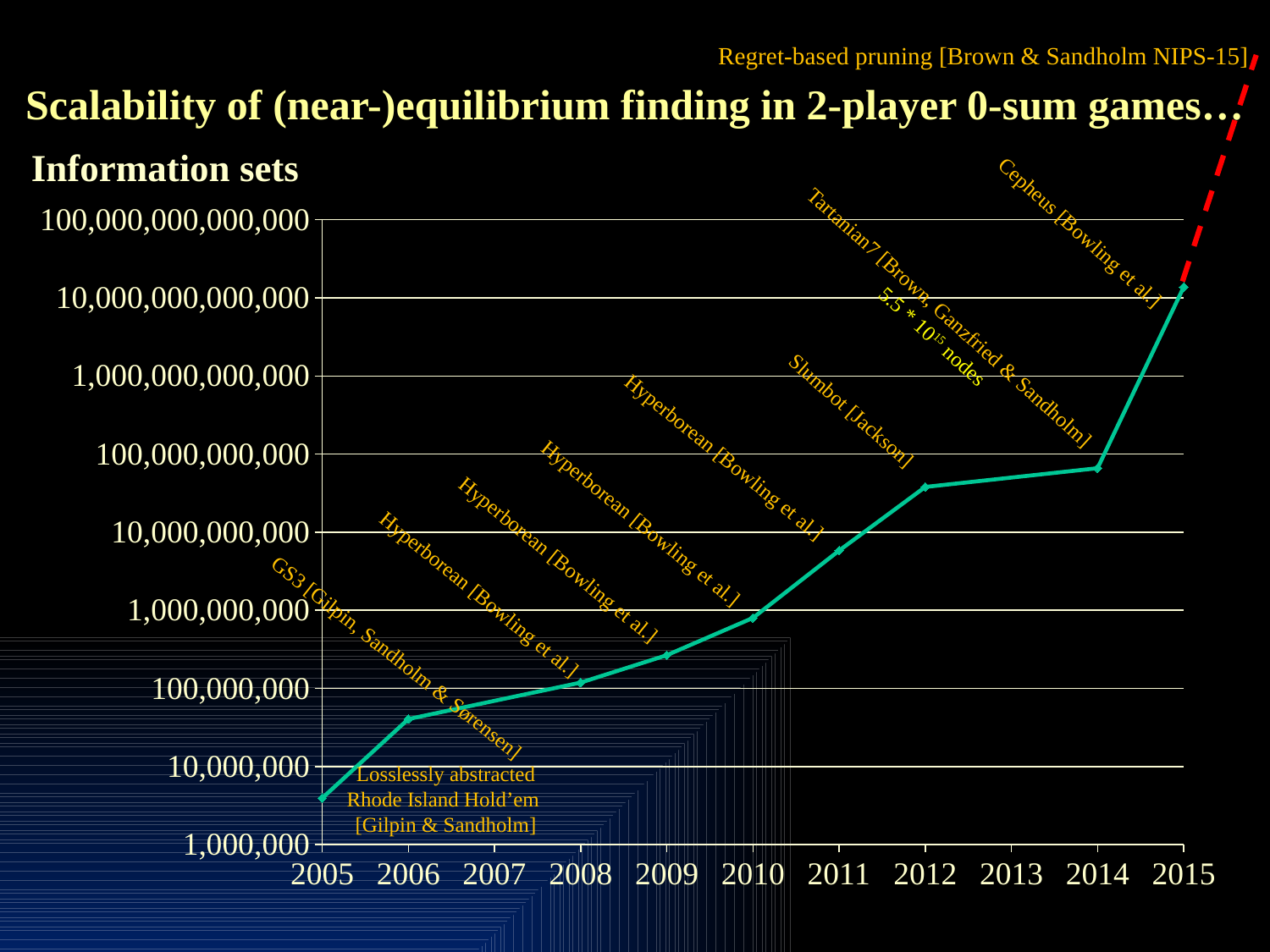
Which is larger, the value for 2011 or the value for 2010? 2011 Is the value for 2006 greater or less than 10,000,000? greater Which year has the highest plotted value? 2015 Is the value for 2012 greater or less than 10,000,000,000? greater What kind of chart is shown on the slide? line chart Is the value for 2015 greater or less than 1,000,000,000,000? greater Which year has the lowest plotted value? 2005 What quantity does the y axis measure, according to the label above it? Information sets What is the first year shown on the x axis? 2005 Do the plotted values rise or fall as the years go from 2005 to 2015? rise